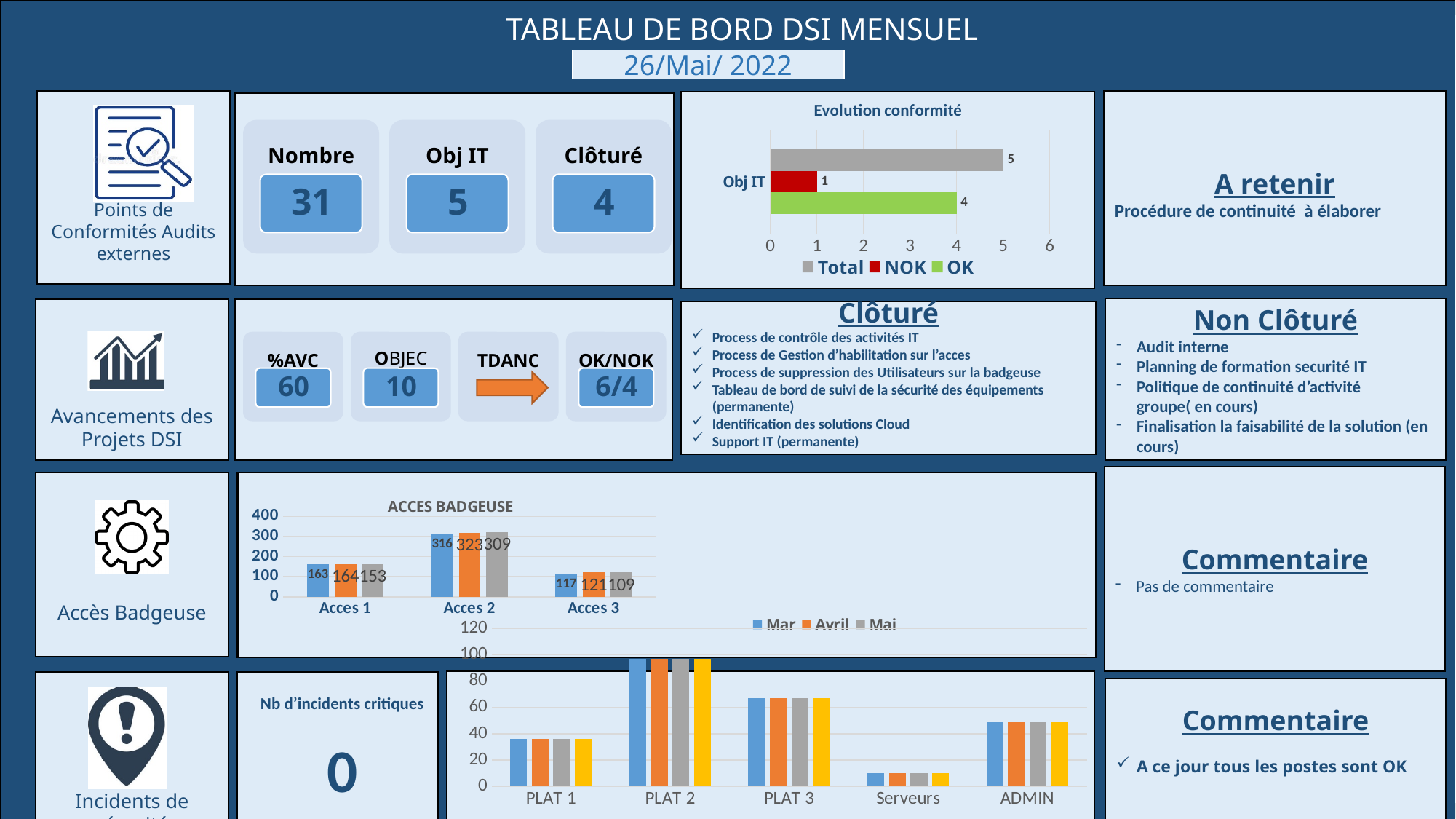
In the 'Evolution conformité' chart, what is the value of the Total bar? 5 In the 'Evolution conformité' chart, how many series does the legend list? 3 In the 'ACCES BADGEUSE' chart, which category has the highest values? Acces 2 In the 'Evolution conformité' chart, what is the value of the NOK bar? 1 In the 'ACCES BADGEUSE' chart, which is larger for Acces 3: the Avril value or the Mar value? Avril In the 'ACCES BADGEUSE' chart, what is the value for Acces 2 in Avril? 323 In the bottom chart with categories PLAT 1 to ADMIN, how many categories are shown on the x axis? 5 In the bottom chart with categories PLAT 1 to ADMIN, are the values for Serveurs greater or less than 20? less In the 'ACCES BADGEUSE' chart, how many categories are shown on the x axis? 3 In the 'ACCES BADGEUSE' chart, what is the value for Acces 3 in Mai? 109 In the 'ACCES BADGEUSE' chart, what is the difference between the Mar and Mai values for Acces 1? 10 In the 'Evolution conformité' chart, what is the difference between the Total and OK values? 1